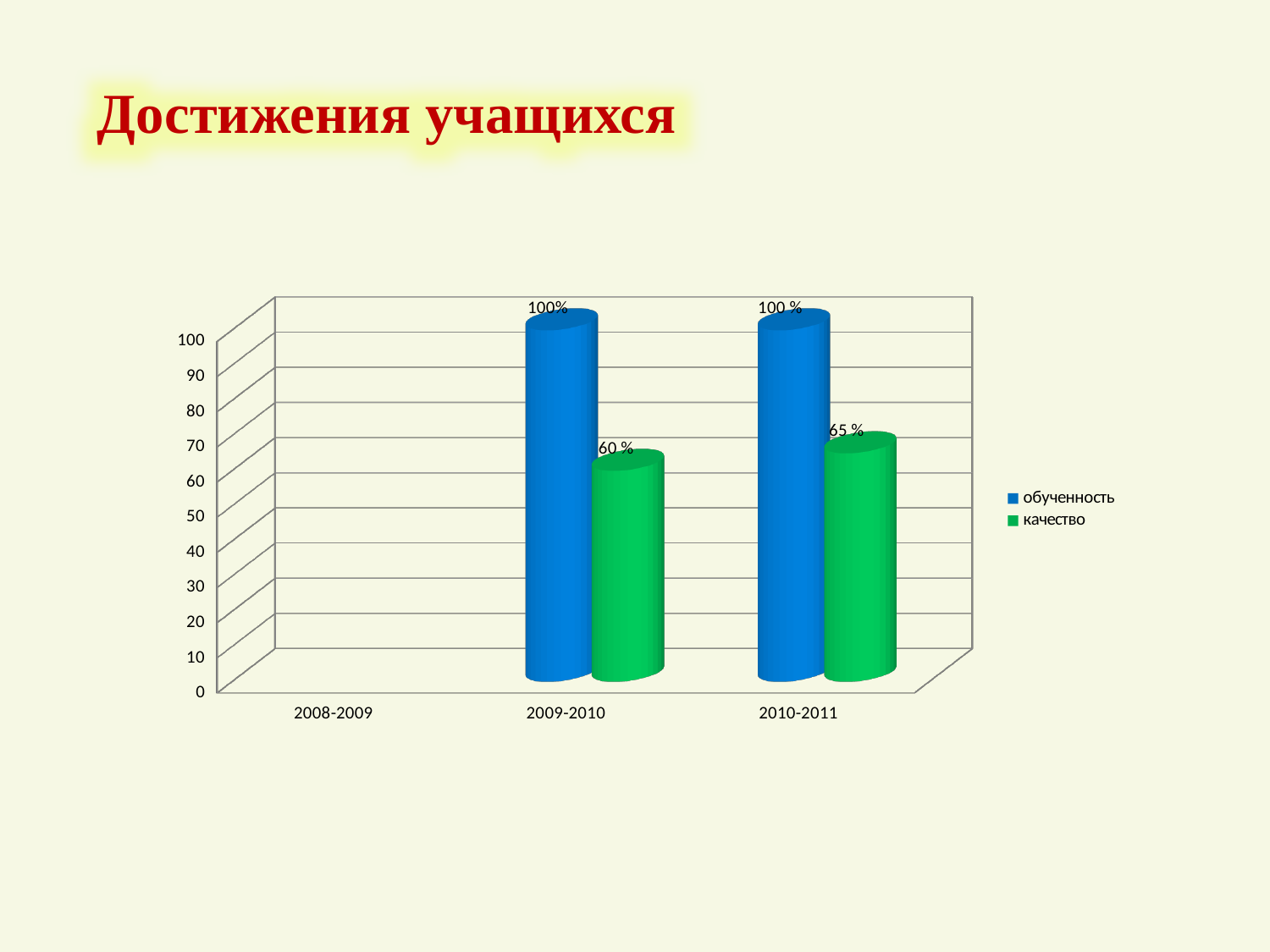
What is the value of качество for 2009-2010? 60 % What is the value of обученность for 2009-2010? 100% How many series does the legend list? 2 How many categories are shown on the x axis? 3 What is the difference between обученность and качество for 2009-2010? 40 What is the difference between качество in 2010-2011 and качество in 2009-2010? 5 What is the value of качество for 2010-2011? 65 % Which year has the higher value for качество, 2009-2010 or 2010-2011? 2010-2011 What kind of chart is shown on the slide? bar chart Is the value of качество for 2010-2011 greater or less than 70? less What is the value of обученность for 2010-2011? 100 % Does the value of качество rise or fall from 2009-2010 to 2010-2011? rise